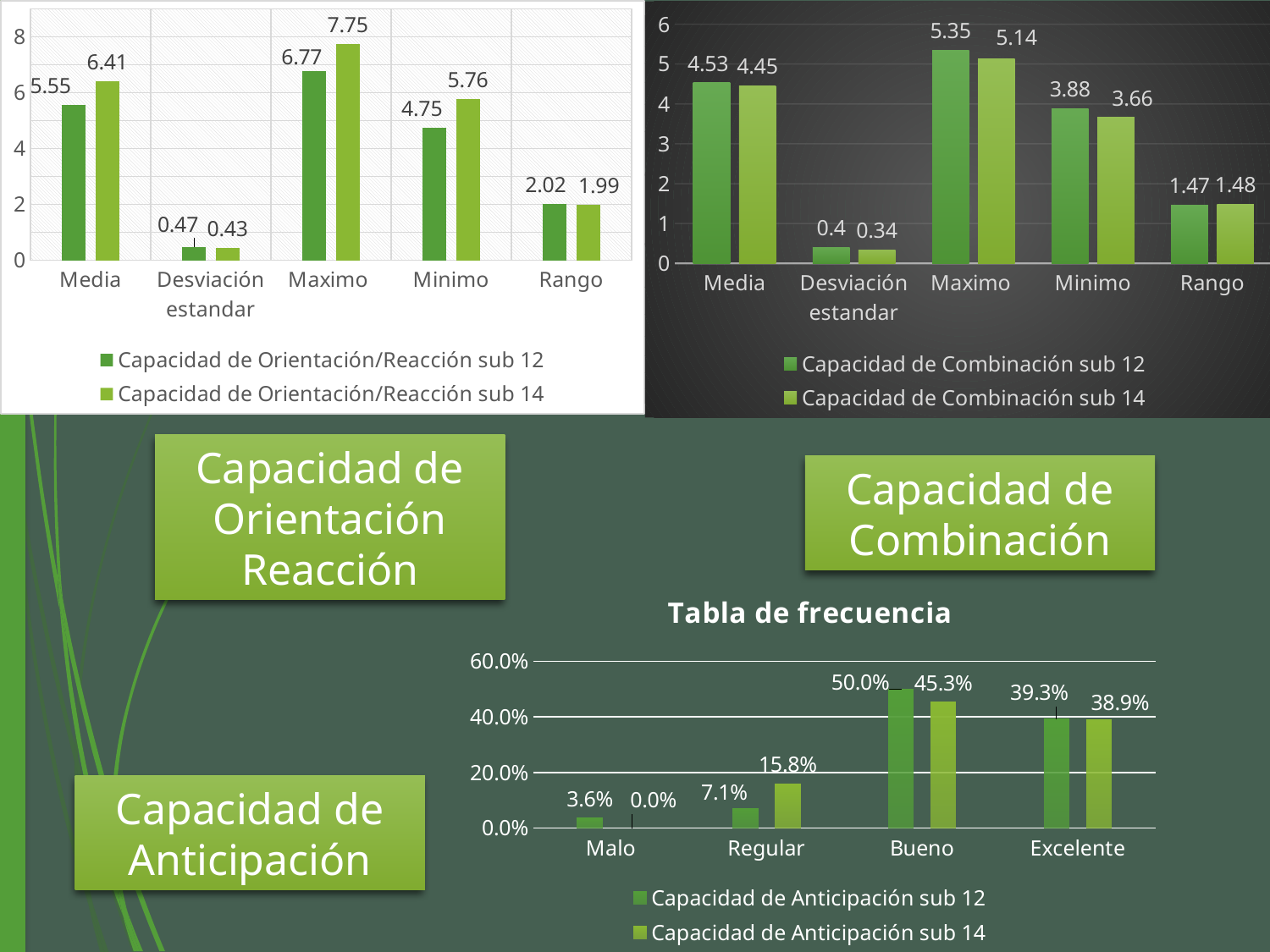
How many categories are shown on the x axis of the top-right chart? 5 In the top-left chart, what is the value of Maximo for Capacidad de Orientación/Reacción sub 14? 7.75 In the top-left chart, what is the difference between the Minimo values of sub 14 and sub 12? 1.01 In the top-left chart, which category has the lowest values for both series? Desviación estandar In the top-left chart, what is the Media value for Capacidad de Orientación/Reacción sub 12? 5.55 In the Tabla de frecuencia chart, what is the difference between the Regular values of sub 14 and sub 12? 8.7% In the Tabla de frecuencia chart, what is the value for Bueno for Capacidad de Anticipación sub 12? 50.0% In the Tabla de frecuencia chart, what is the value for Malo for Capacidad de Anticipación sub 14? 0.0% In the top-right chart, what is the difference between the Media values of sub 12 and sub 14? 0.08 In the top-right chart, what is the Maximo value for Capacidad de Combinación sub 12? 5.35 In the top-right chart, which is larger for Rango: sub 12 or sub 14? sub 14 How many series does the legend of the Tabla de frecuencia chart list? 2